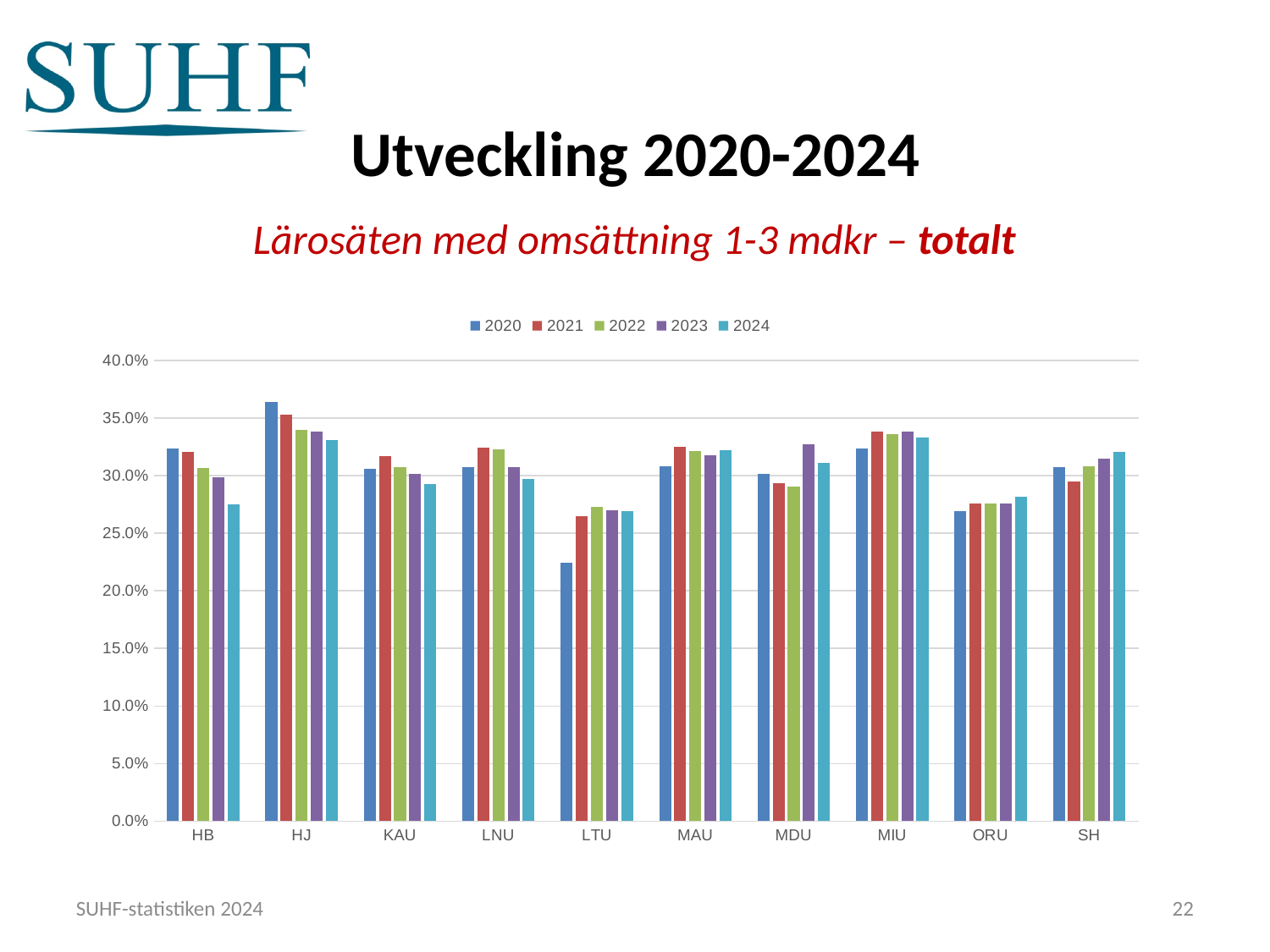
Which is larger, the 2020 value for ORU or the 2020 value for LTU? ORU Do the values for LTU rise or fall from 2020 to 2024? rise Which institution has the lowest value for 2020? LTU How many series does the legend list? 5 Which institution has the highest value for 2020? HJ Is the 2020 value for LTU greater or less than 25.0%? less What kind of chart is shown on the slide? bar chart How many categories (institutions) are shown on the x axis? 10 Is the 2021 value for MIU greater or less than 30.0%? greater Do the values for HB rise or fall from 2020 to 2024? fall Is the 2024 value for HB greater or less than 30.0%? less